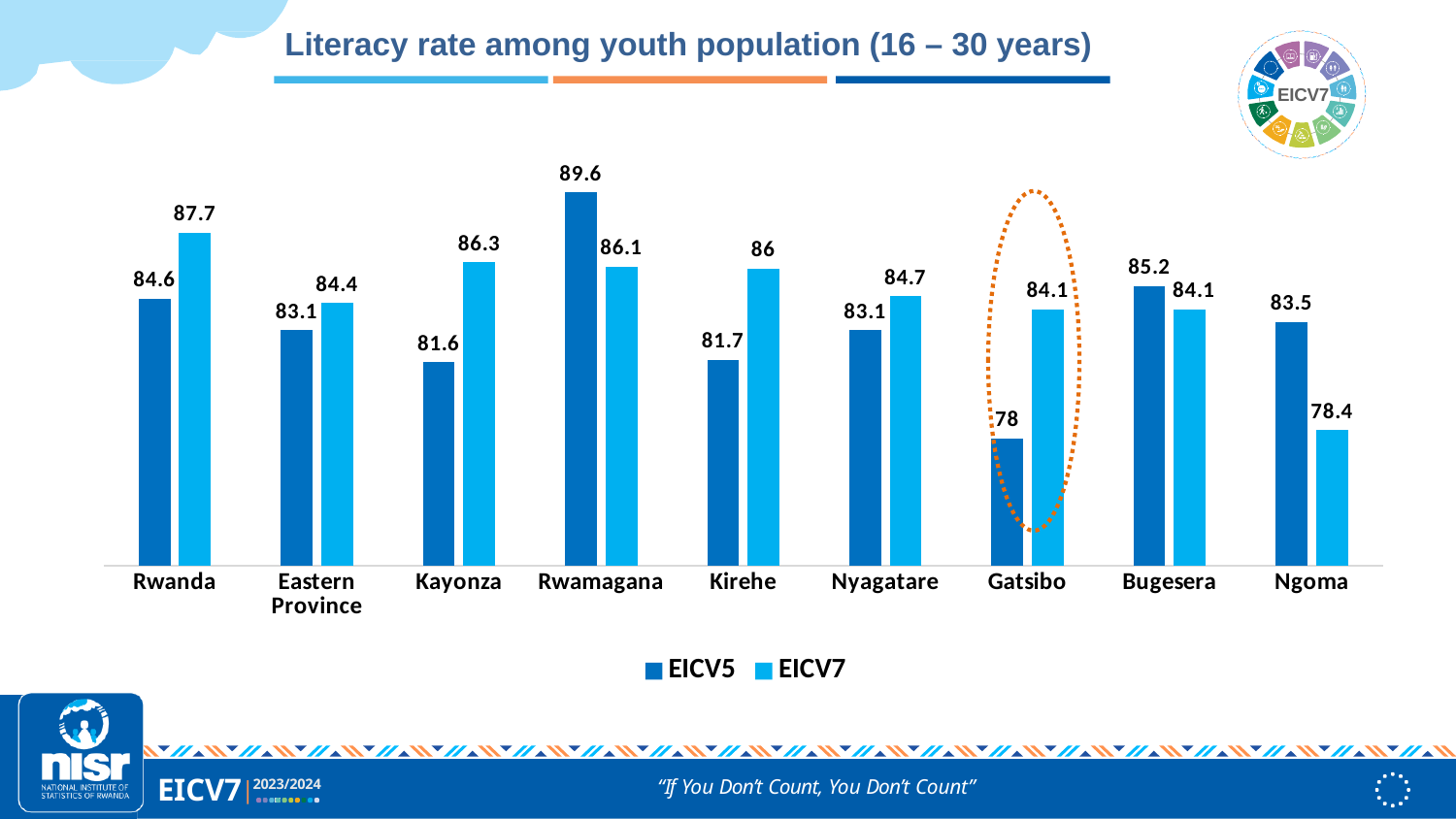
Which category has the highest EICV5 value? Rwamagana What is the EICV7 literacy rate for Rwanda? 87.7 Which is larger for Bugesera, the EICV5 value or the EICV7 value? EICV5 How many series does the legend list? 2 Which is larger for Kayonza, the EICV5 value or the EICV7 value? EICV7 What kind of chart is shown on the slide? Bar chart What is the difference between the EICV7 and EICV5 values for Gatsibo? 6.1 What is the difference between the EICV5 and EICV7 values for Ngoma? 5.1 How many categories are shown on the x axis? 9 What is the EICV5 literacy rate for Gatsibo? 78 What is the EICV7 value for Kirehe? 86 Which category has the lowest EICV7 value? Ngoma